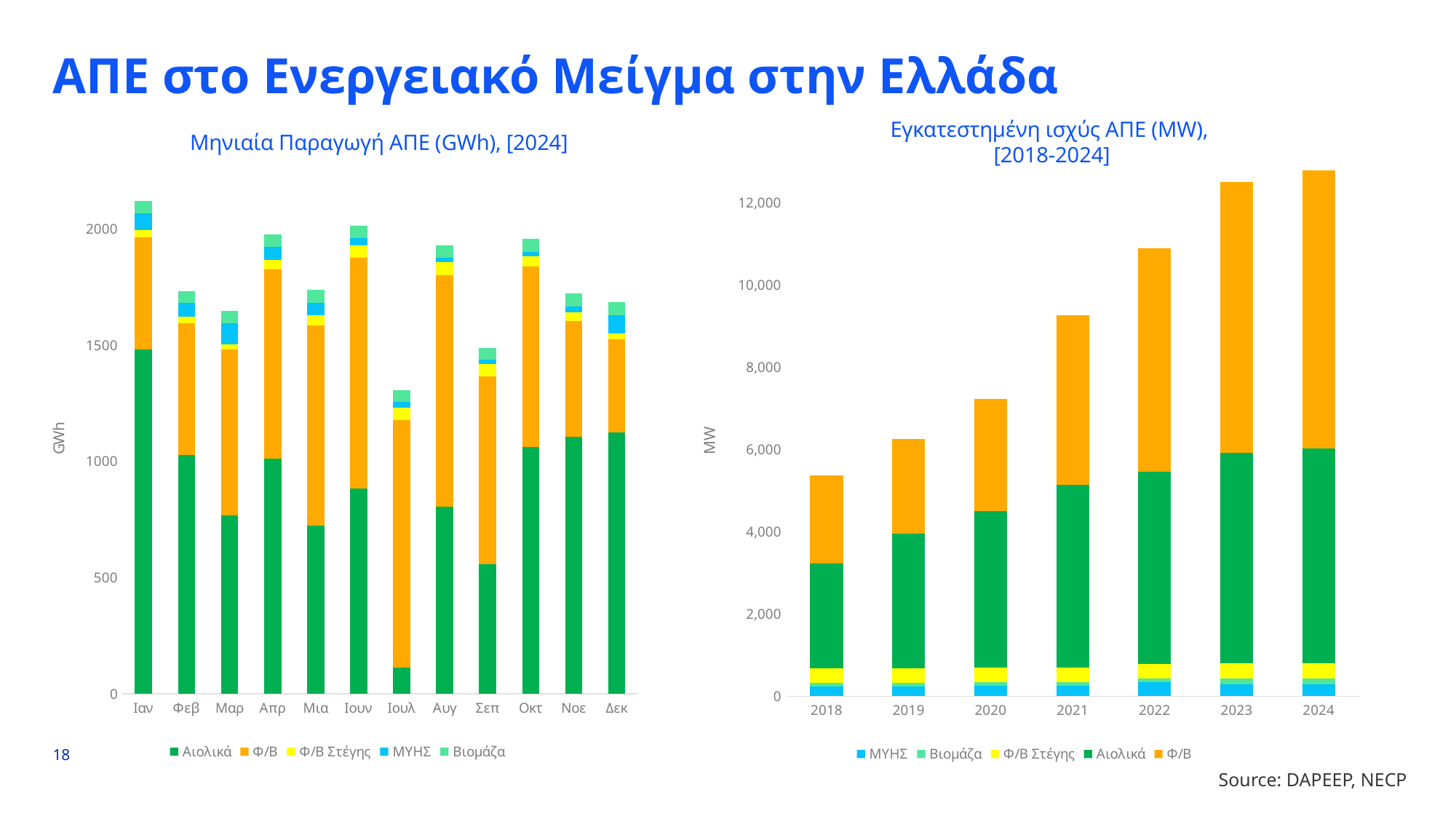
In the right chart 'Εγκατεστημένη ισχύς ΑΠΕ (MW), [2018-2024]', how many years are shown on the x axis? 7 In the right chart 'Εγκατεστημένη ισχύς ΑΠΕ (MW), [2018-2024]', is the total for 2024 greater or less than 12,000? greater In the right chart 'Εγκατεστημένη ισχύς ΑΠΕ (MW), [2018-2024]', do the total bars rise or fall from 2018 to 2024? rise In the left chart 'Μηνιαία Παραγωγή ΑΠΕ (GWh), [2024]', which month has the lowest total bar? Ιουλ In the left chart 'Μηνιαία Παραγωγή ΑΠΕ (GWh), [2024]', is the Αιολικά value for Ιουλ greater or less than 500? less In the left chart 'Μηνιαία Παραγωγή ΑΠΕ (GWh), [2024]', is the total for Ιουλ greater or less than 1500? less What is the y-axis label of the right chart 'Εγκατεστημένη ισχύς ΑΠΕ (MW), [2018-2024]'? MW In the left chart 'Μηνιαία Παραγωγή ΑΠΕ (GWh), [2024]', how many months are shown on the x axis? 12 In the left chart 'Μηνιαία Παραγωγή ΑΠΕ (GWh), [2024]', how many series does the legend list? 5 In the right chart 'Εγκατεστημένη ισχύς ΑΠΕ (MW), [2018-2024]', which year has a larger total bar, 2018 or 2024? 2024 In the left chart 'Μηνιαία Παραγωγή ΑΠΕ (GWh), [2024]', which month has the highest total bar? Ιαν What type of chart is the left chart titled 'Μηνιαία Παραγωγή ΑΠΕ (GWh), [2024]'? Stacked bar chart